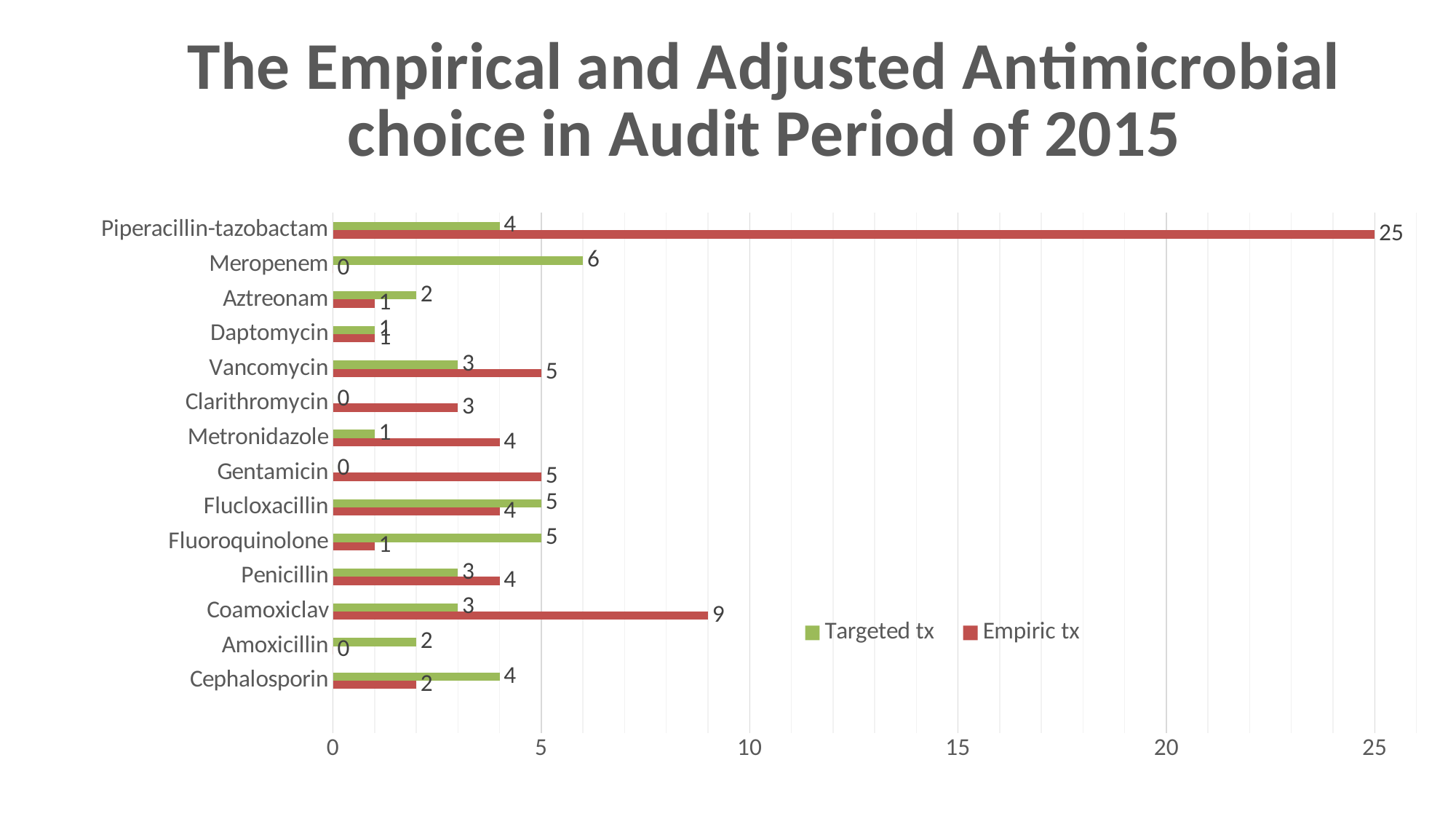
Which antimicrobial has the highest Targeted tx value? Meropenem What is the Targeted tx value for Meropenem? 6 Which antimicrobial has the highest Empiric tx value? Piperacillin-tazobactam What is the Empiric tx value for Coamoxiclav? 9 What is the Targeted tx value for Fluoroquinolone? 5 What type of chart is shown on the slide? Bar chart What is the Empiric tx value for Piperacillin-tazobactam? 25 How many antimicrobial categories are shown on the chart? 14 For Cephalosporin, which is larger: Targeted tx or Empiric tx? Targeted tx What is the difference between the Empiric tx and Targeted tx values for Coamoxiclav? 6 How many series does the legend list? 2 What is the difference between the Empiric tx and Targeted tx values for Piperacillin-tazobactam? 21